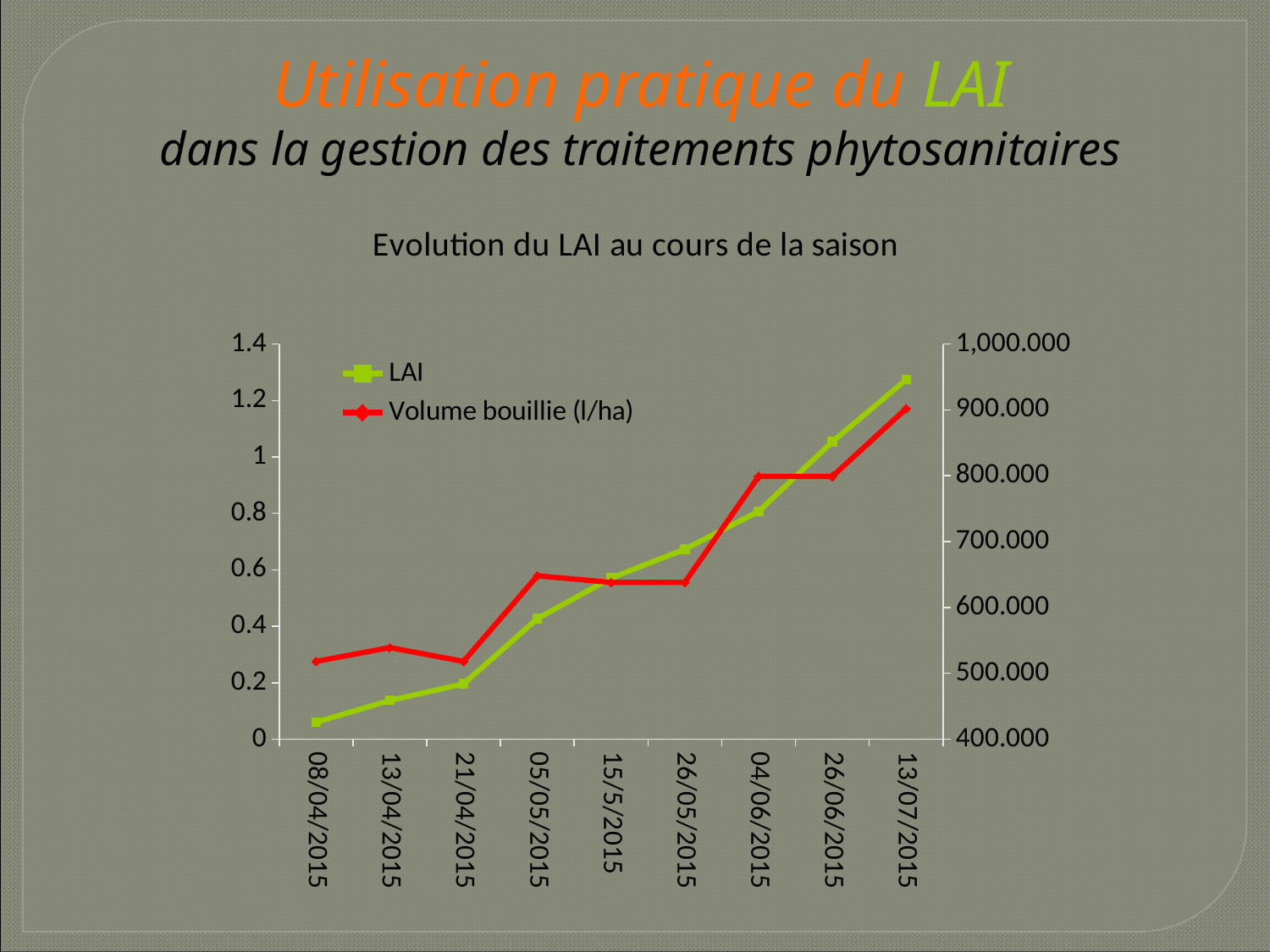
Does the LAI series rise or fall over the season along the x axis? rise Is the Volume bouillie (l/ha) value for 08/04/2015 greater or less than 600.000? less Is the LAI value for 13/07/2015 greater or less than 1.2? greater What kind of chart is shown on the slide? line chart How many series does the legend list? 2 On which date is the LAI value highest? 13/07/2015 On which date is the Volume bouillie (l/ha) value highest? 13/07/2015 Is the Volume bouillie (l/ha) value for 13/07/2015 greater or less than 800.000? greater How many dates are plotted along the x axis? 9 Which is larger, the LAI value for 26/06/2015 or for 05/05/2015? 26/06/2015 On which date is the LAI value lowest? 08/04/2015